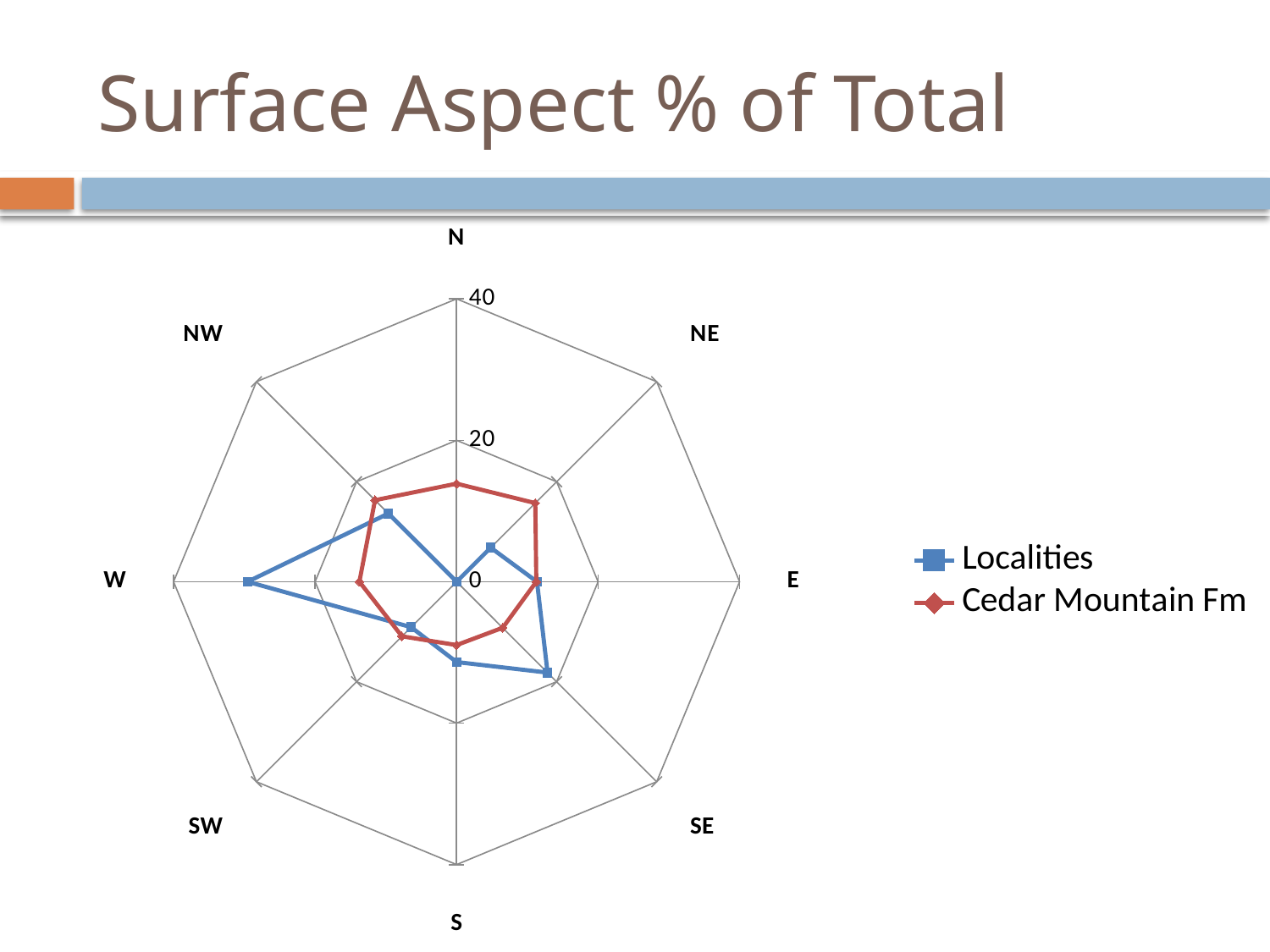
What kind of chart is shown on the slide? Radar chart Is the Cedar Mountain Fm value for NW greater or less than 20? less At N, which series has the larger value, Localities or Cedar Mountain Fm? Cedar Mountain Fm How many aspect categories are plotted around the chart? 8 Is the Localities value for W greater or less than 40? less At W, which series has the larger value, Localities or Cedar Mountain Fm? Localities Is the Localities value for W greater or less than 20? greater Which series are listed in the legend? Localities and Cedar Mountain Fm For the Localities series, which aspect has the lowest value? N What is the title of the slide containing the chart? Surface Aspect % of Total For the Localities series, which aspect has the highest value? W How many series does the legend list? 2